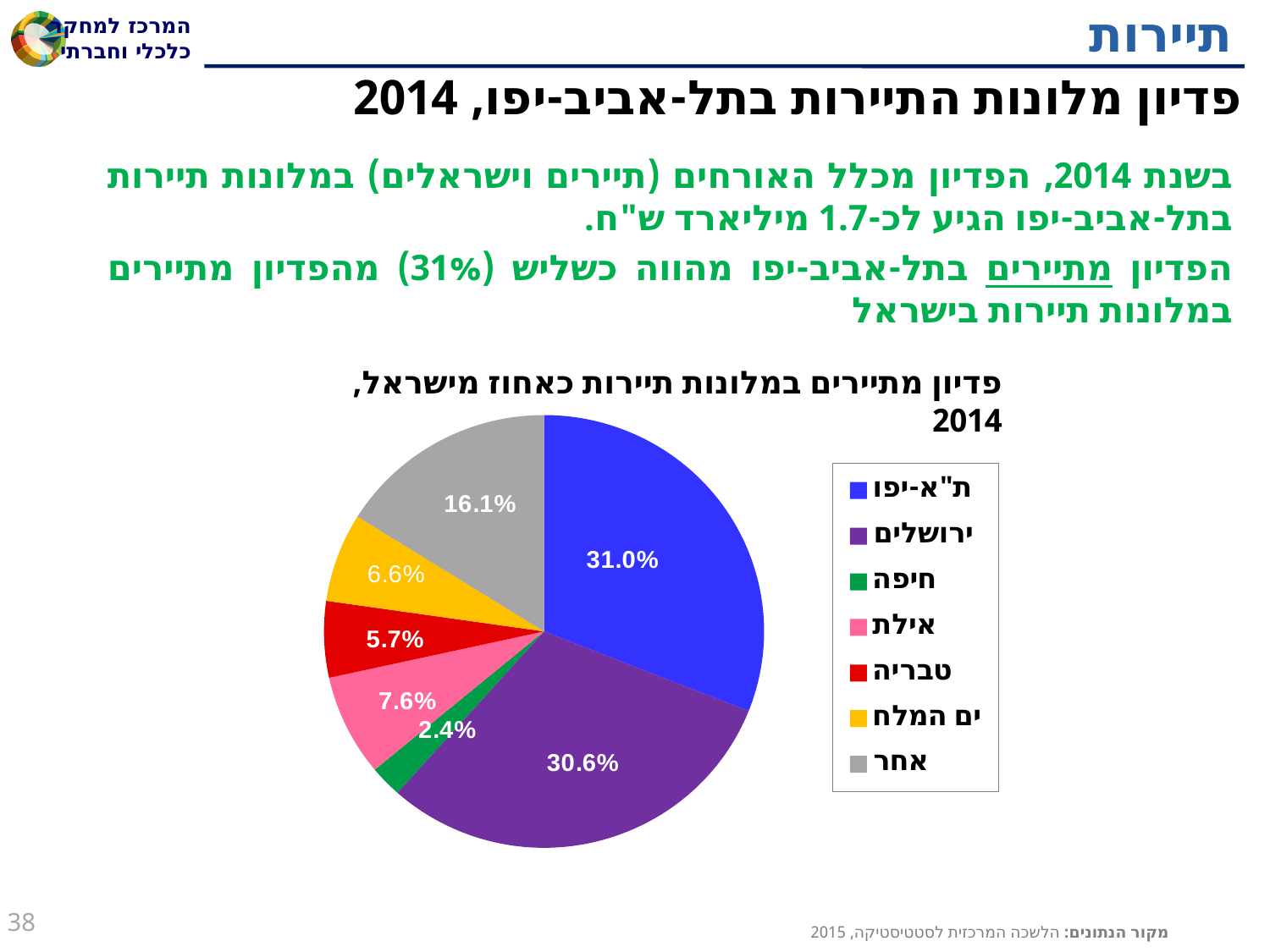
Which category has the largest slice of the pie? ת"א-יפו What is the difference between the shares of ת"א-יפו and ירושלים? 0.4% What kind of chart is shown on the slide? Pie chart Which category has the smallest slice of the pie? חיפה What percentage is shown for אילת? 7.6% Which category is shown in gray in the pie chart? אחר What is the combined share of טבריה and ים המלח? 12.3% Which is larger, the share for אילת or the share for טבריה? אילת How many categories does the pie chart show? 7 What is the value for ים המלח? 6.6% What is the value shown for ירושלים? 30.6% What share of the pie does ת"א-יפו hold? 31.0%